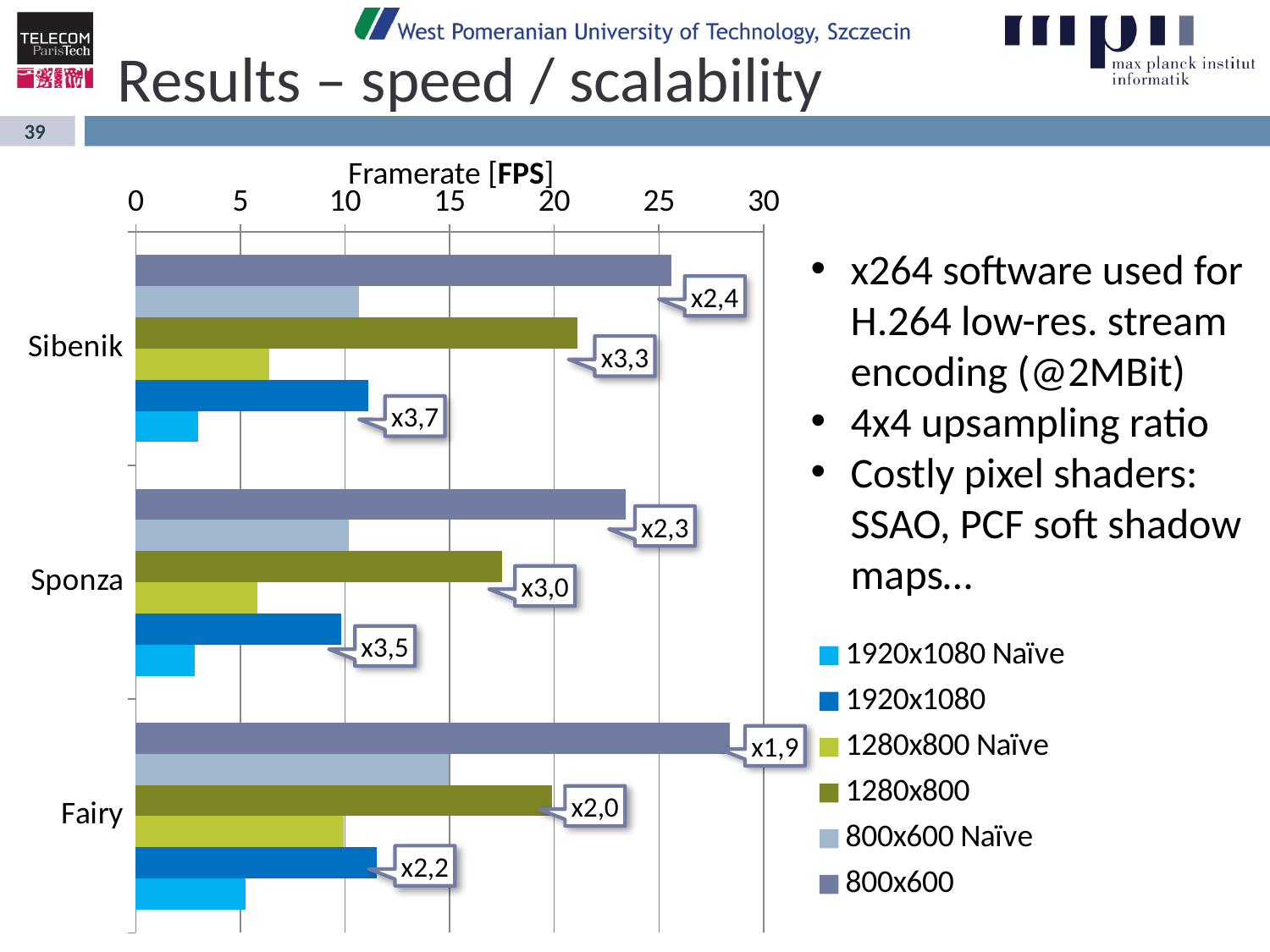
What speed-up factor is shown in the callout next to the 800x600 bar for Fairy? x1,9 Which scene has the lowest framerate for the 1280x800 series? Sponza How many scenes (categories) are plotted on the chart? 3 Is the 1280x800 framerate for Sponza greater or less than 20 FPS? less For Sibenik, which series has the higher framerate: 1280x800 or 1920x1080? 1280x800 What kind of chart is shown on the slide? bar chart What speed-up factor is shown in the callout next to the 1920x1080 bar for Sibenik? x3,7 Is the 800x600 framerate for Fairy greater or less than 25 FPS? greater How many series does the chart legend list? 6 What is the title of the horizontal axis of the chart? Framerate [FPS] Is the 1920x1080 Naïve framerate for Sponza greater or less than 5 FPS? less Which scene has the highest framerate for the 800x600 series? Fairy